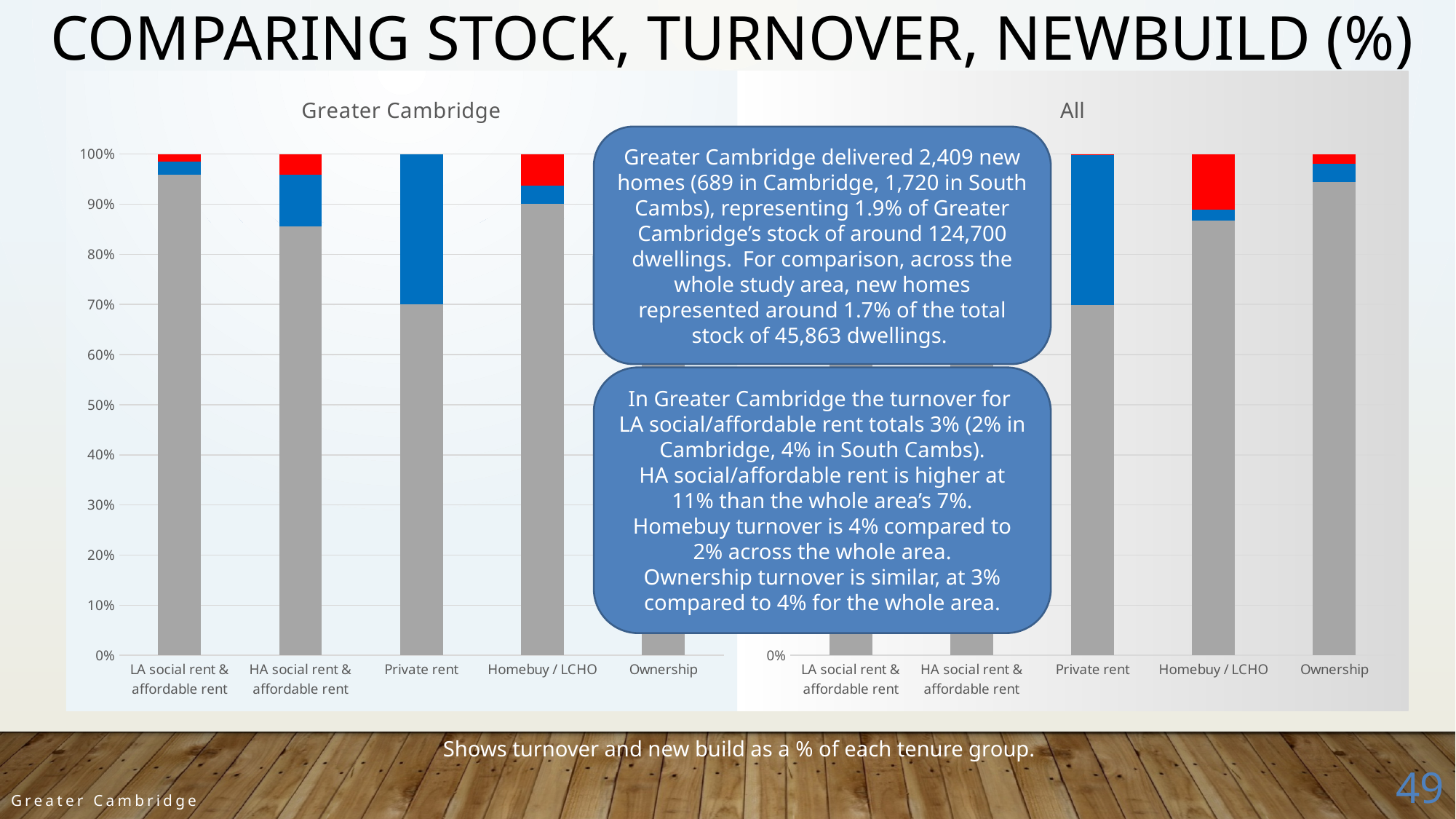
In the "Greater Cambridge" chart, which category has the smallest grey segment? Private rent In the "All" chart, which category has the largest blue segment? Private rent What are the titles of the two charts on the slide? Greater Cambridge and All In the "All" chart, which has the larger red segment: Homebuy / LCHO or Ownership? Homebuy / LCHO How many tenure categories are shown on the x axis of the "All" chart? 5 In the "Greater Cambridge" chart, is the top of the grey segment for HA social rent & affordable rent greater or less than 80%? greater In the "Greater Cambridge" chart, is the top of the grey segment for Ownership greater or less than 90%? greater In the "Greater Cambridge" chart, which has the larger blue segment: Private rent or HA social rent & affordable rent? Private rent In the "All" chart, is the top of the grey segment for Ownership greater or less than 90%? greater What kind of chart is the "Greater Cambridge" chart? Stacked bar chart How many tenure categories are shown on the x axis of the "Greater Cambridge" chart? 5